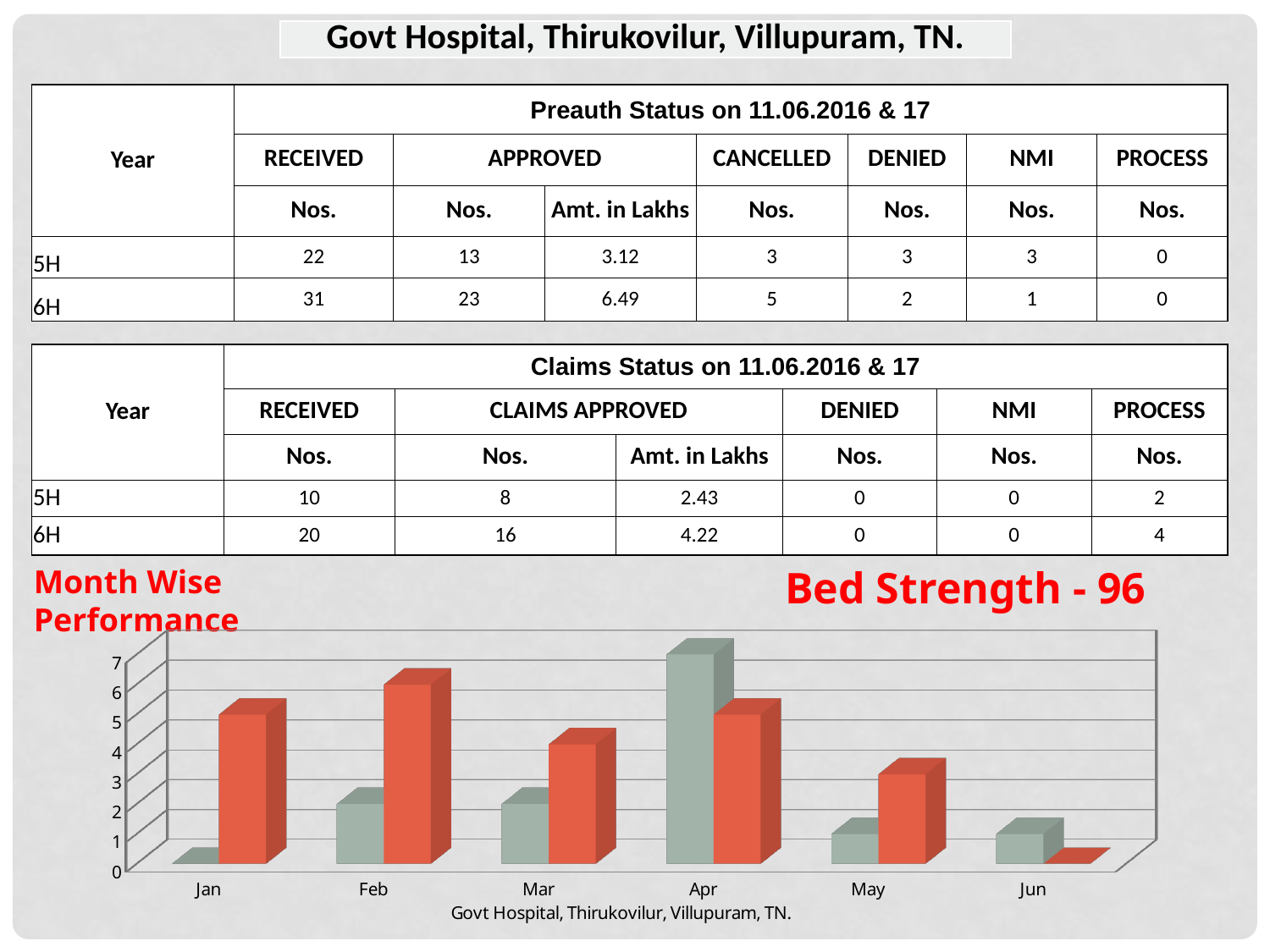
How many months are shown on the x axis of the Month Wise Performance chart? 6 In the Month Wise Performance chart, is the red bar for Feb or the red bar for Mar taller? Feb In the Month Wise Performance chart, is the grey bar for Apr greater or less than 6? greater In the Month Wise Performance chart, for Apr, is the grey bar or the red bar taller? grey In the Month Wise Performance chart, which month has the tallest red bar? Feb What kind of chart is shown at the bottom of the slide? bar chart In the Month Wise Performance chart, which month has the shortest red bar? Jun In the Month Wise Performance chart, is the red bar for May greater or less than 4? less What text appears below the x axis of the Month Wise Performance chart? Govt Hospital, Thirukovilur, Villupuram, TN. In the Month Wise Performance chart, do the red bars rise or fall from Apr to Jun? fall In the Month Wise Performance chart, which month has the tallest grey bar? Apr How many bars are plotted for each month in the Month Wise Performance chart? 2